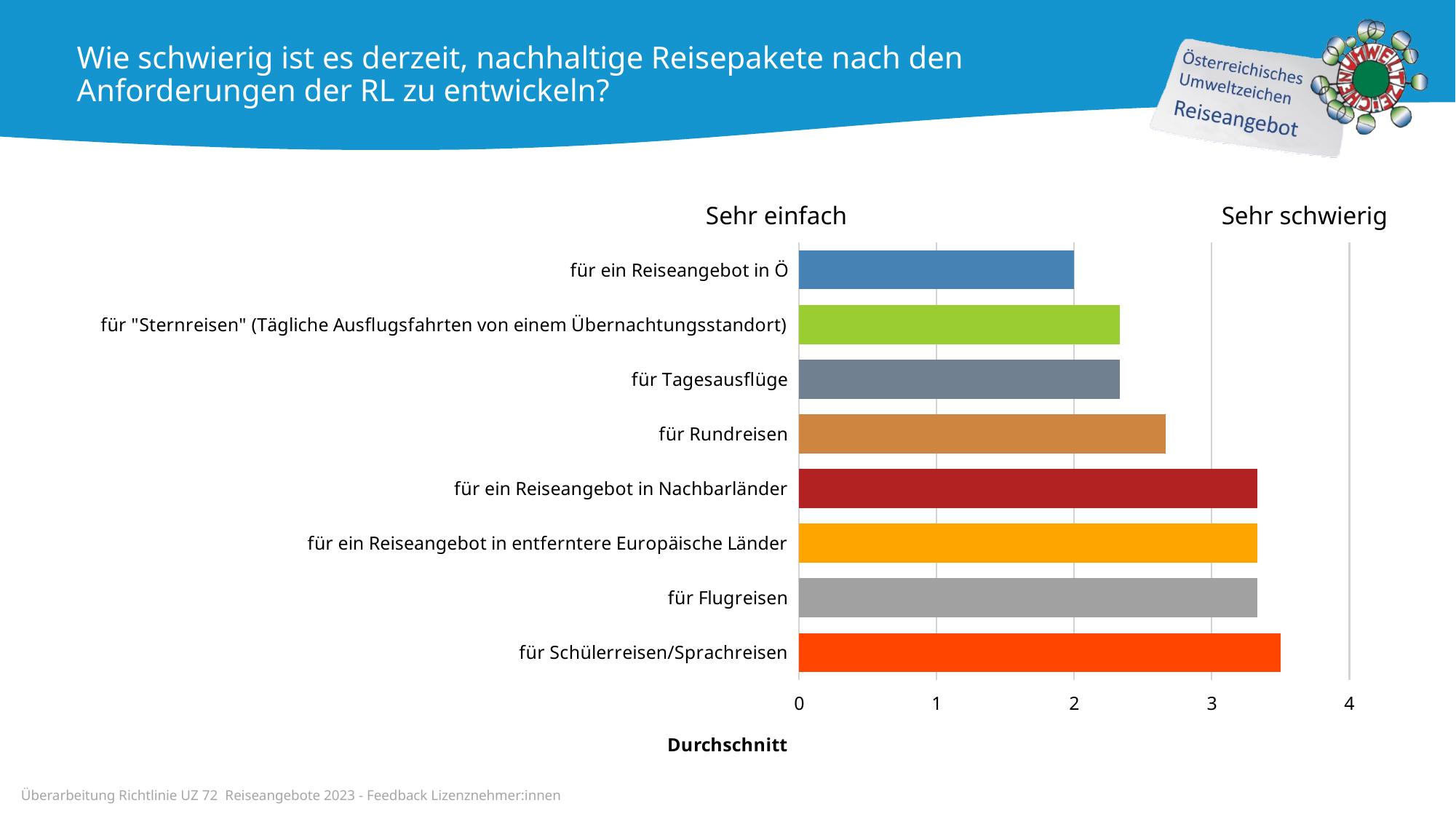
Which has the larger value: "für Rundreisen" or "für Tagesausflüge"? für Rundreisen What is the value for "für ein Reiseangebot in Ö"? 2 Which category has the lowest value in the chart? für ein Reiseangebot in Ö What kind of chart is shown on the slide? bar chart Is the value for "für Tagesausflüge" greater or less than 3? less Which category has the highest value in the chart? für Schülerreisen/Sprachreisen How many categories are plotted in the chart? 8 Is the value for "für Flugreisen" greater or less than 3? greater What label appears at the right end of the scale above the chart? Sehr schwierig Is the value for "für Rundreisen" greater or less than 3? less What is the label of the horizontal axis of the chart? Durchschnitt